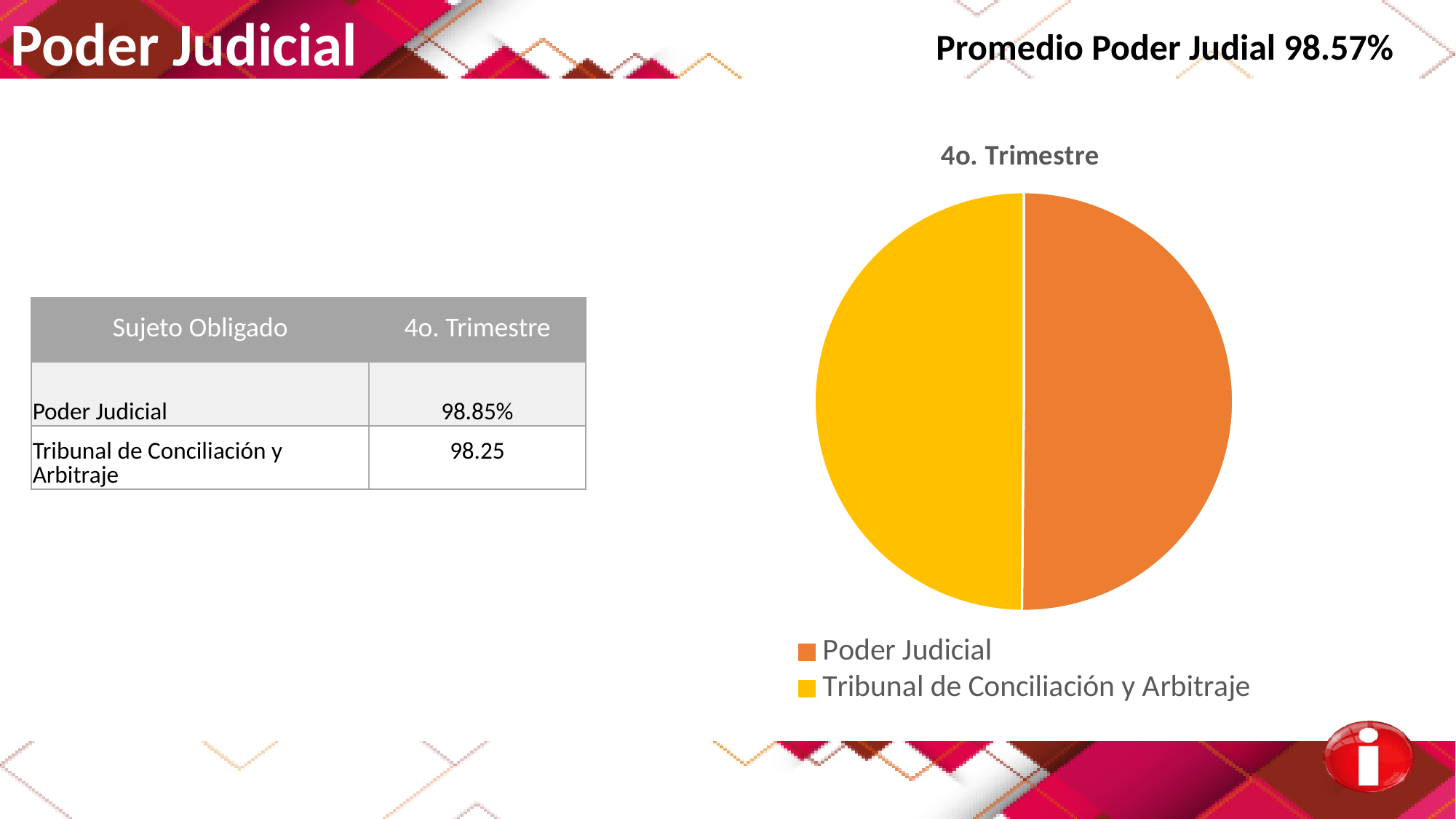
How many slices does the pie chart have? 2 What kind of chart is shown on the slide? pie chart Based on the values in the table, which has the larger 4o. Trimestre value, Poder Judicial or Tribunal de Conciliación y Arbitraje? Poder Judicial According to the table, what is the 4o. Trimestre value for Poder Judicial? 98.85% What colour is the Poder Judicial slice in the pie chart? orange What is the title of the pie chart? 4o. Trimestre According to the table, what is the 4o. Trimestre value for Tribunal de Conciliación y Arbitraje? 98.25 How many entries does the pie chart's legend list? 2